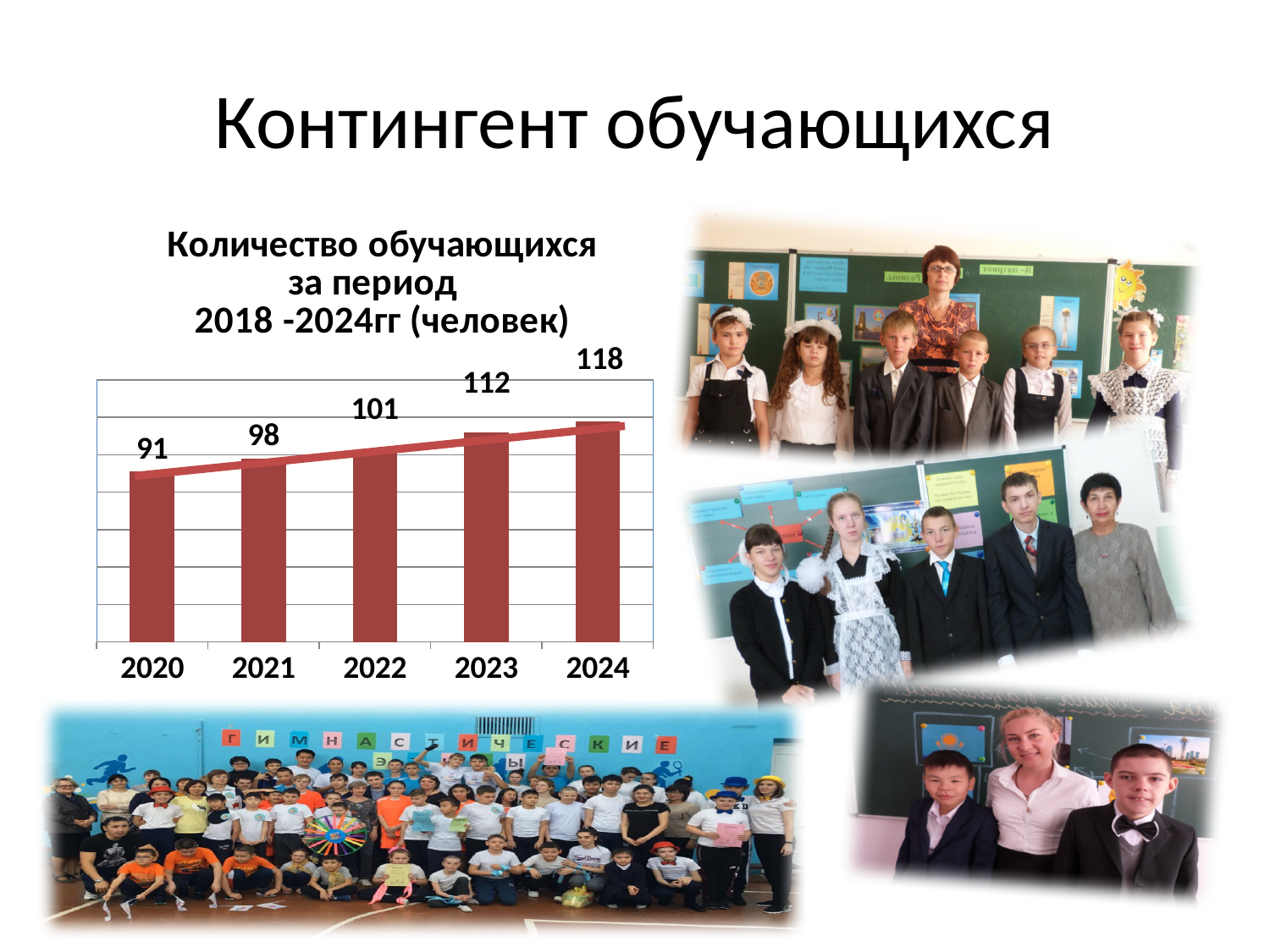
Which year has the lowest number of students? 2020 What is the number of students in 2020? 91 Which year has the highest number of students? 2024 What is the title of the chart? Количество обучающихся за период 2018 -2024гг (человек) How many years are shown on the x axis of the chart? 5 What kind of chart is shown on the slide? bar chart Which year has more students, 2021 or 2023? 2023 Do the values rise or fall from 2020 to 2024? rise What is the number of students in 2024? 118 What is the difference between the number of students in 2024 and in 2020? 27 What is the difference between the number of students in 2023 and in 2022? 11 What is the number of students in 2022? 101